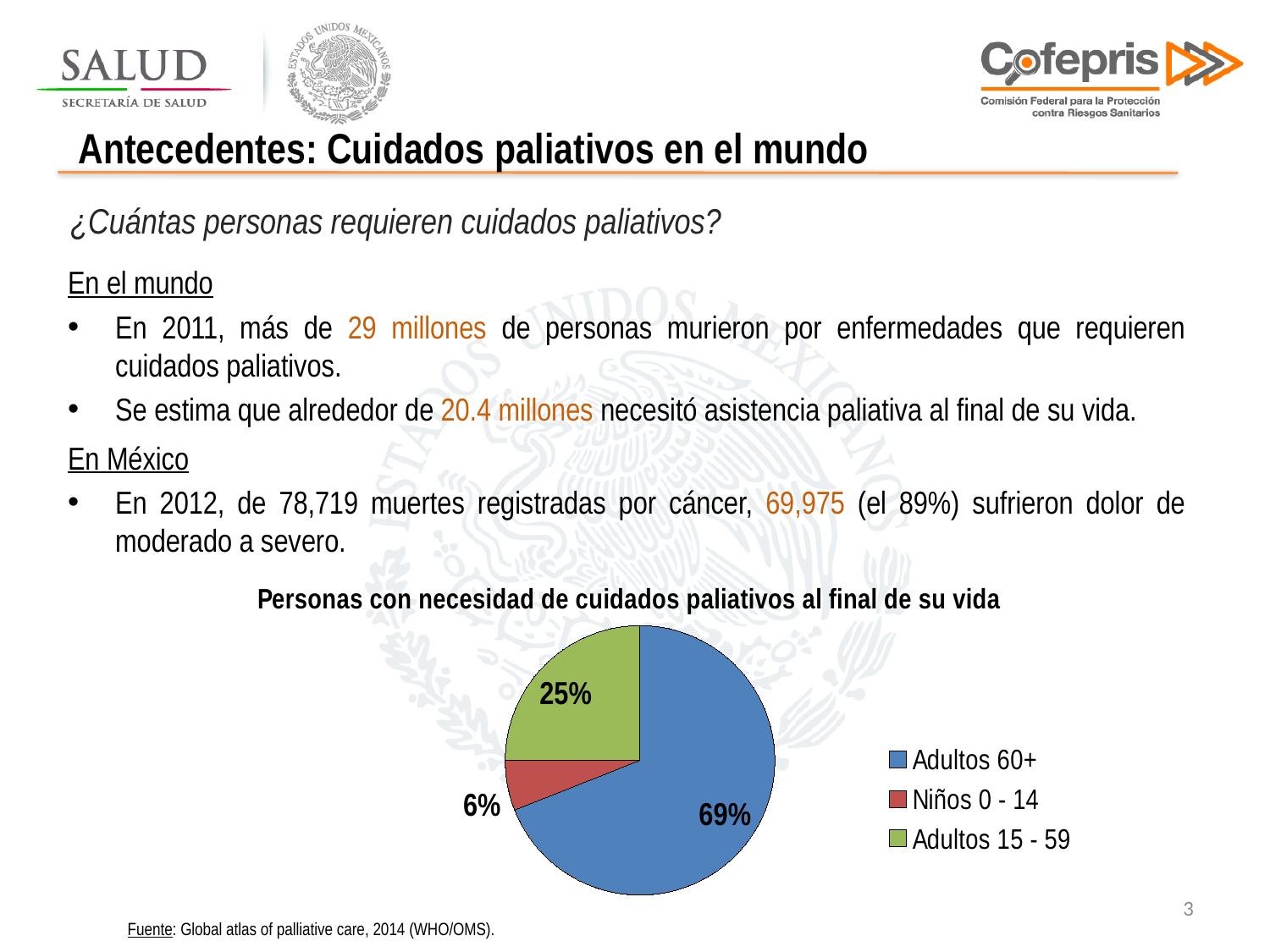
What share of the pie does Niños 0 - 14 represent? 6% What kind of chart is shown on the slide? pie chart What share of the pie does Adultos 15 - 59 represent? 25% What is the title of the chart? Personas con necesidad de cuidados paliativos al final de su vida How many categories does the pie chart show? 3 Which is larger, the share for Adultos 15 - 59 or the share for Niños 0 - 14? Adultos 15 - 59 Which category has the smallest slice of the pie? Niños 0 - 14 What share of the pie does Adultos 60+ represent? 69% What colour is the slice for Adultos 15 - 59? green What is the difference in percentage points between Adultos 60+ and Adultos 15 - 59? 44 What is the difference in percentage points between Adultos 15 - 59 and Niños 0 - 14? 19 Which category has the largest slice of the pie? Adultos 60+